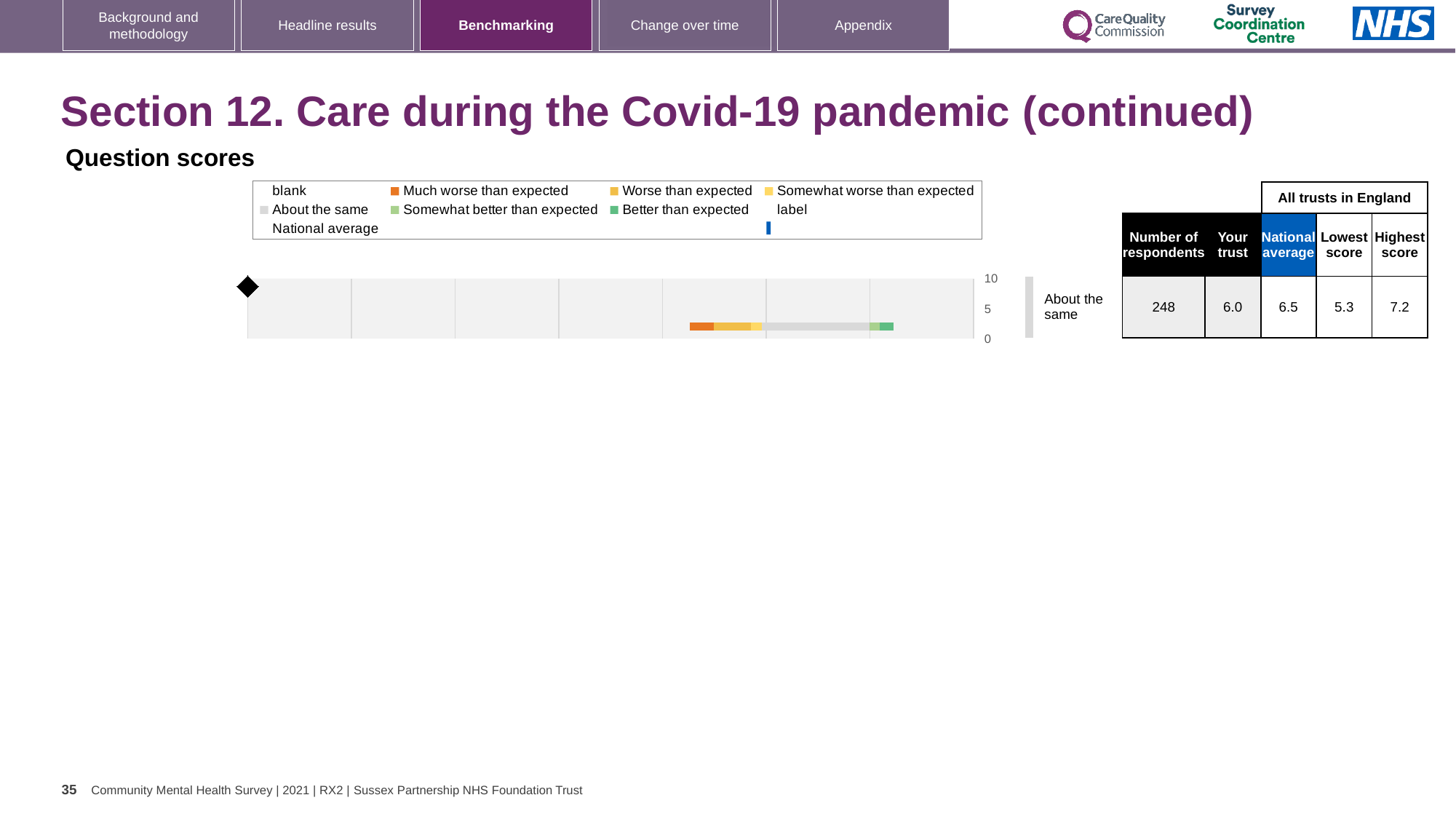
What is the highest score among all trusts in England shown in the table? 7.2 Is the 'Your trust' score greater or less than 5? greater What is the 'Your trust' score shown in the table? 6.0 What is the number of respondents shown in the table next to the chart? 248 What is the national average score shown in the table? 6.5 What benchmark category label is shown next to the bar in the chart? About the same What kind of chart is shown under 'Question scores'? bar chart What is the lowest score among all trusts in England shown in the table? 5.3 Which is larger, the 'Your trust' score or the national average? National average What is the difference between the highest score and the lowest score in the table? 1.9 What is the difference between the national average and the 'Your trust' score? 0.5 Which colour in the legend represents 'Much worse than expected'? Orange